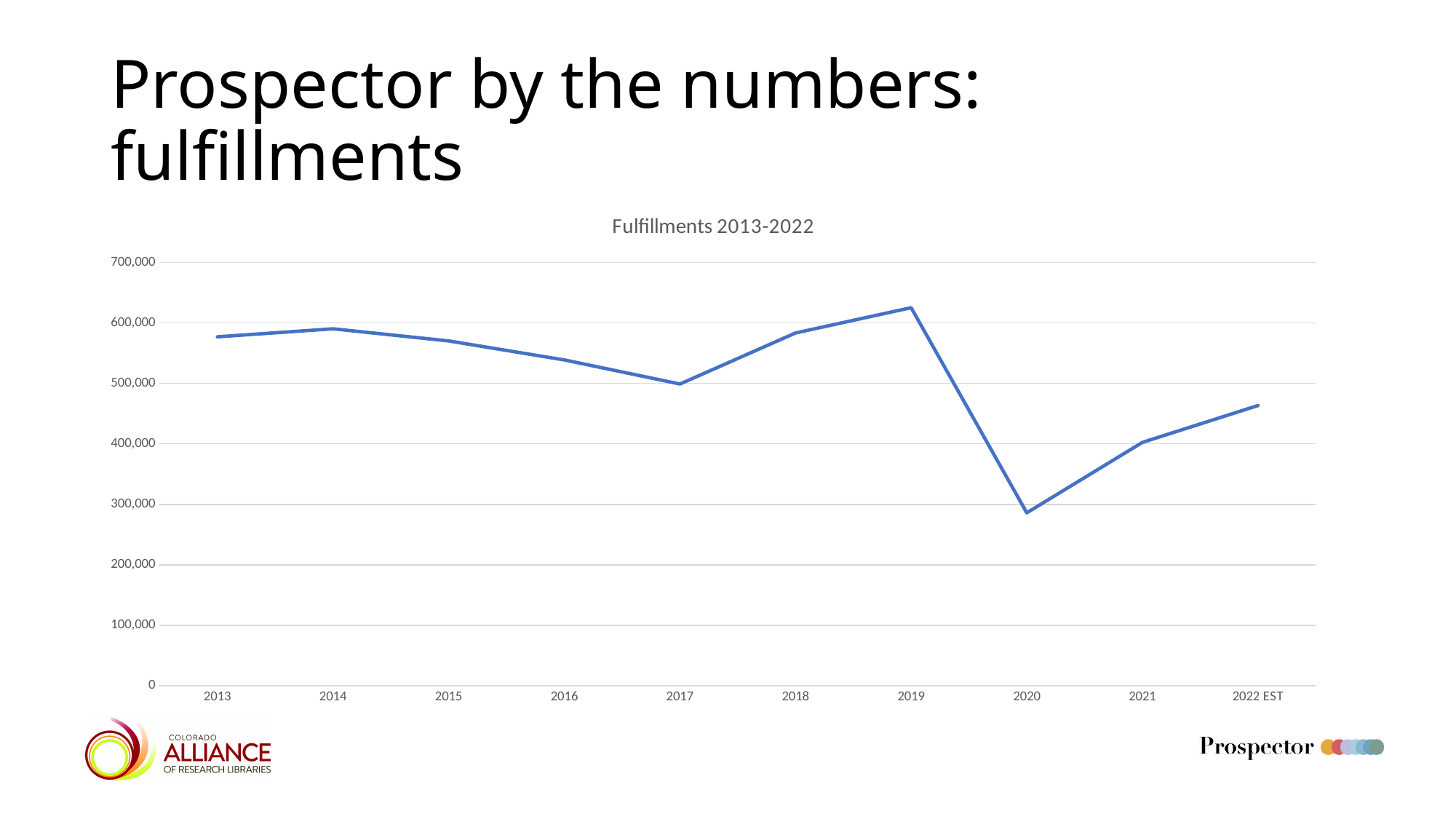
Which year has the lowest number of fulfillments? 2020 Which year has the highest number of fulfillments? 2019 Is the value for 2020 greater or less than 300,000? less What is the title of the chart? Fulfillments 2013-2022 What kind of chart is shown on the slide? line chart Is the value for 2016 greater or less than 500,000? greater Is the value for 2022 EST greater or less than 500,000? less How many years are plotted on the x axis of the chart? 10 Do fulfillments rise or fall from 2020 to 2022 EST? rise Which year has more fulfillments, 2014 or 2017? 2014 Which has more fulfillments, 2021 or 2022 EST? 2022 EST